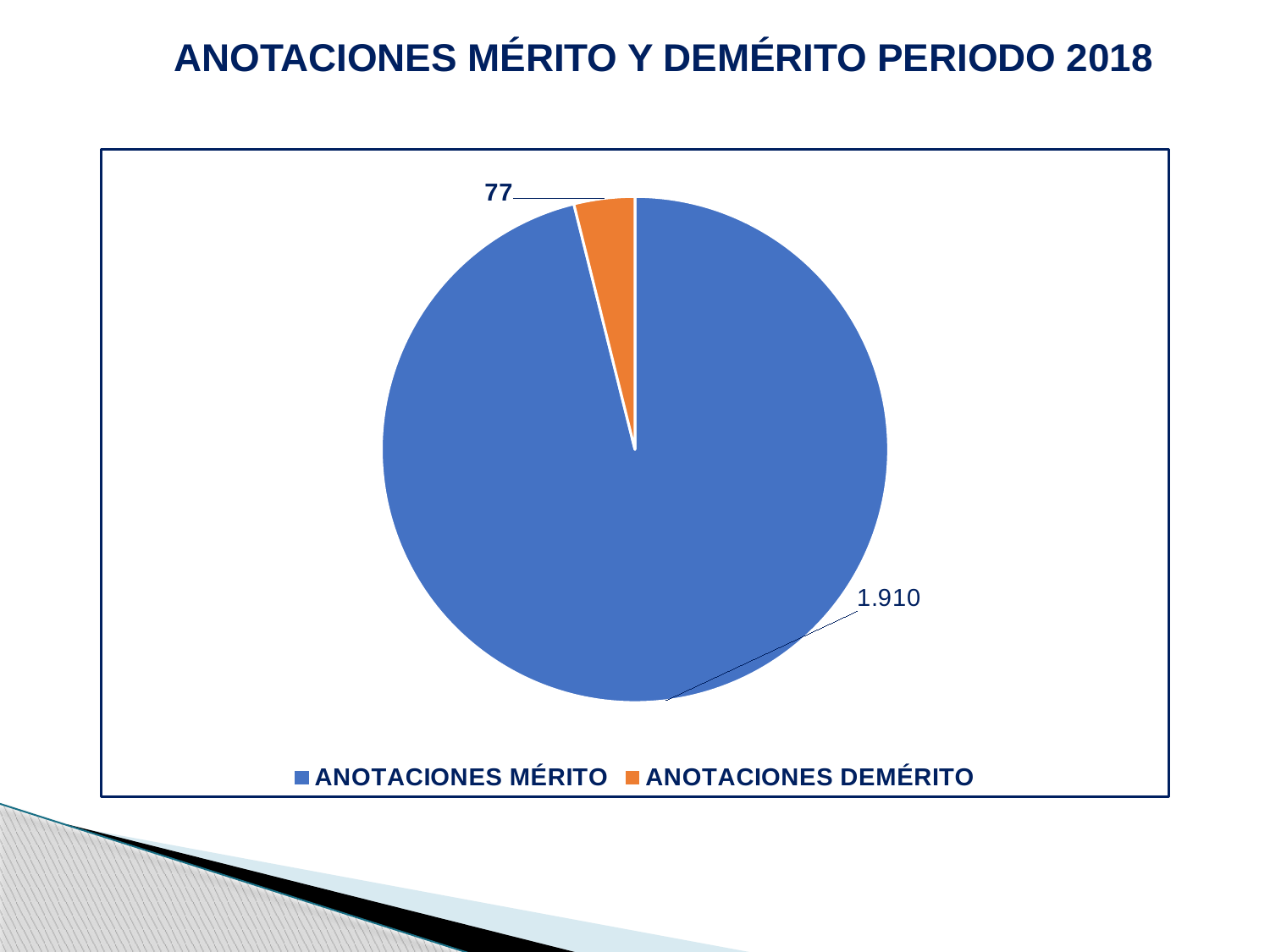
How many entries does the legend list? 2 What is the difference between the values for ANOTACIONES MÉRITO and ANOTACIONES DEMÉRITO? 1.833 What is the value for ANOTACIONES MÉRITO? 1.910 What is the title of the slide? ANOTACIONES MÉRITO Y DEMÉRITO PERIODO 2018 What is the total of the two slices in the pie chart? 1.987 Which category has the largest slice of the pie? ANOTACIONES MÉRITO Which is larger, ANOTACIONES MÉRITO or ANOTACIONES DEMÉRITO? ANOTACIONES MÉRITO What is the value for ANOTACIONES DEMÉRITO? 77 What colour is the slice for ANOTACIONES DEMÉRITO? Orange What kind of chart is shown on the slide? Pie chart How many slices does the pie chart have? 2 Which category has the smallest slice of the pie? ANOTACIONES DEMÉRITO